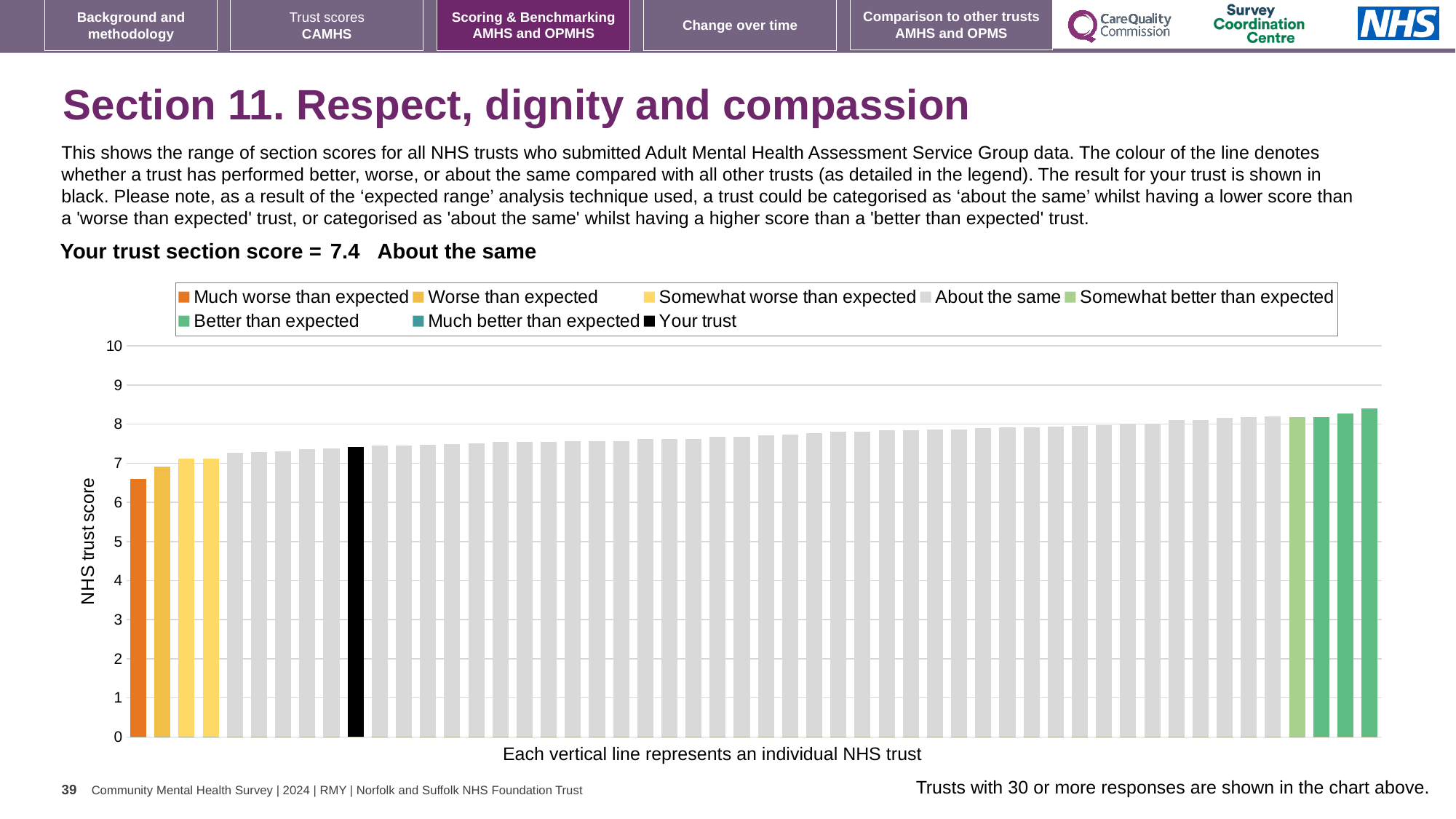
Is the value for your trust's bar greater or less than 7? greater Do the bar values rise or fall from left to right along the x axis? rise Is the value of the orange 'Much worse than expected' bar greater or less than 7? less What kind of chart is shown on the slide? bar chart What colour is the bar representing your trust? black Which is larger: the bar for your trust or the orange 'Much worse than expected' bar? Your trust Is the value for your trust's bar greater or less than 8? less What is the section score for your trust shown on the slide? 7.4 What is the label on the vertical axis of the chart? NHS trust score How many entries does the chart legend list? 8 How many bars are coloured orange (Much worse than expected)? 1